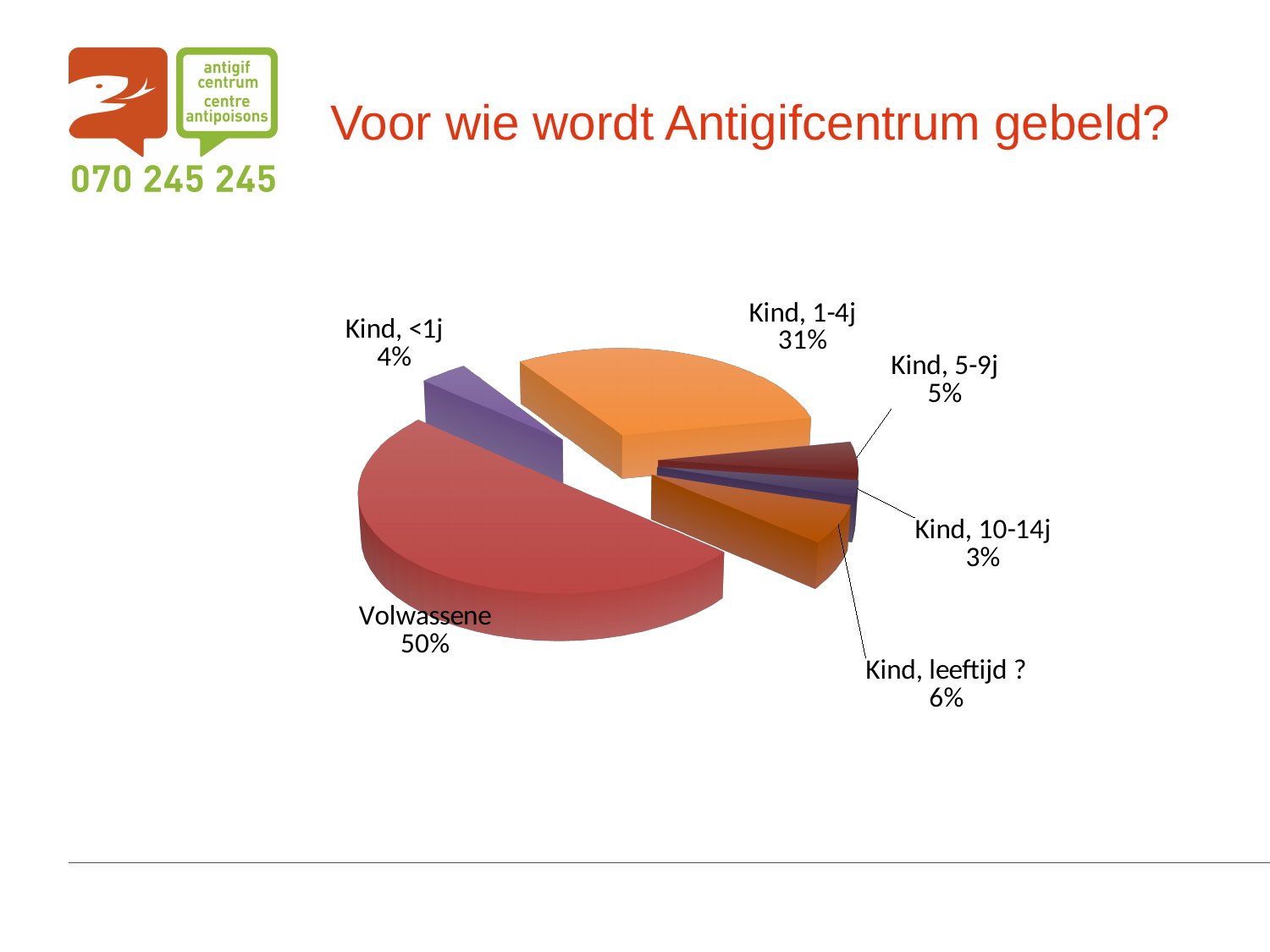
What is the title of the slide containing the chart? Voor wie wordt Antigifcentrum gebeld? How many categories are shown in the pie chart? 6 What is the difference in percentage points between Volwassene and Kind, 1-4j? 19 Which category has the smallest slice of the pie? Kind, 10-14j What share of calls is for Kind, 10-14j? 3% What share of calls is for Kind, <1j? 4% What share of calls is for Volwassene? 50% What share of calls is for Kind, 1-4j? 31% What share of calls is for Kind, leeftijd ? 6% Which category has the largest slice of the pie? Volwassene Which is larger, the share for Kind, 5-9j or the share for Kind, leeftijd ? Kind, leeftijd ? What kind of chart is shown on the slide? Pie chart